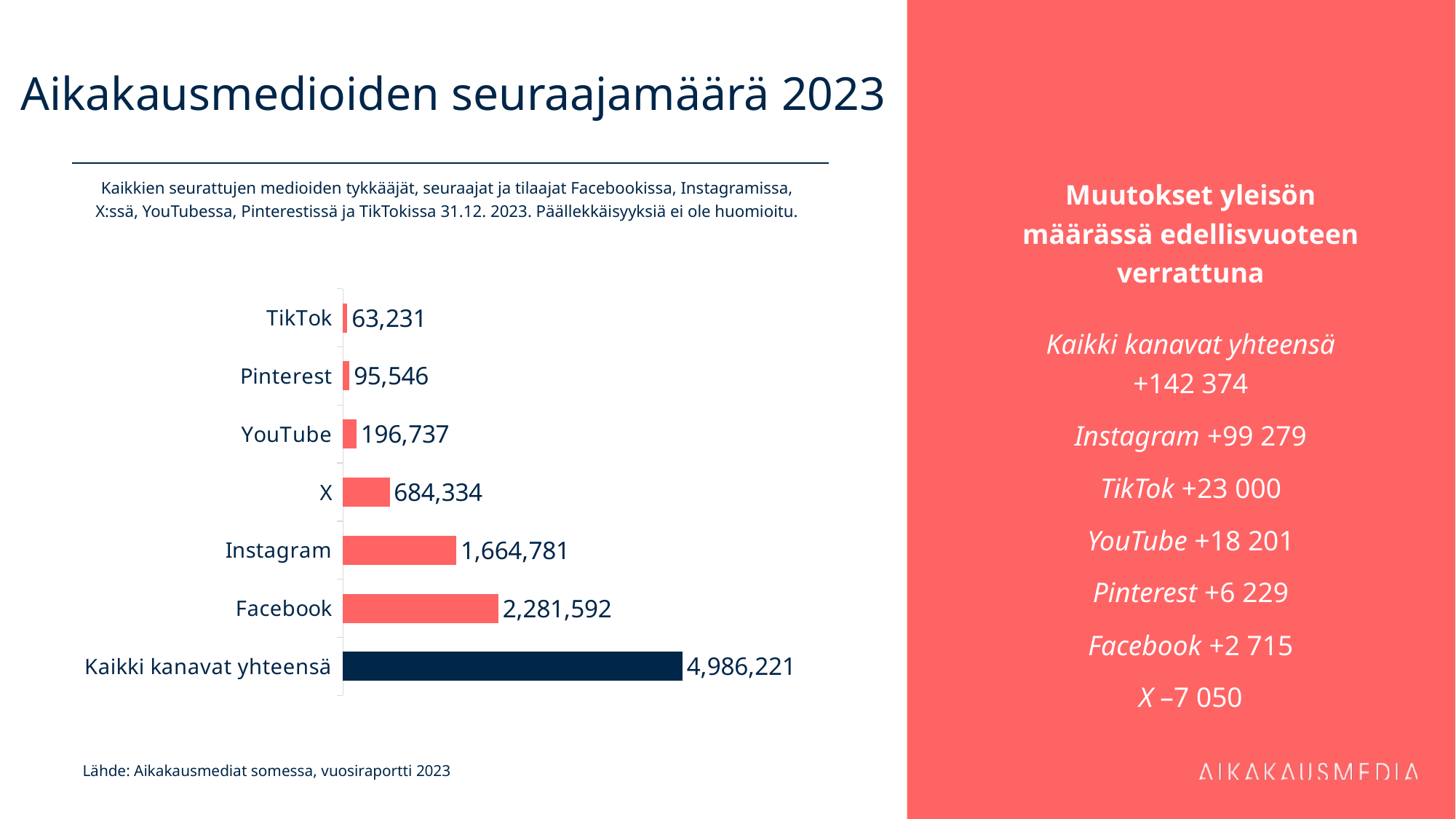
What is the value for Kaikki kanavat yhteensä in the chart? 4,986,221 What is the difference between the values for Facebook and Instagram? 616,811 Which category has the highest value in the chart? Kaikki kanavat yhteensä What is the difference between the values for Pinterest and TikTok? 32,315 What kind of chart is shown on the slide? Bar chart Which bar in the chart is coloured dark navy rather than red? Kaikki kanavat yhteensä What is the value for X in the chart? 684,334 Which category has the lowest value in the chart? TikTok What is the value for Facebook in the chart? 2,281,592 How many categories are shown in the chart? 7 What is the value for TikTok in the chart? 63,231 Which has a larger value, YouTube or Pinterest? YouTube